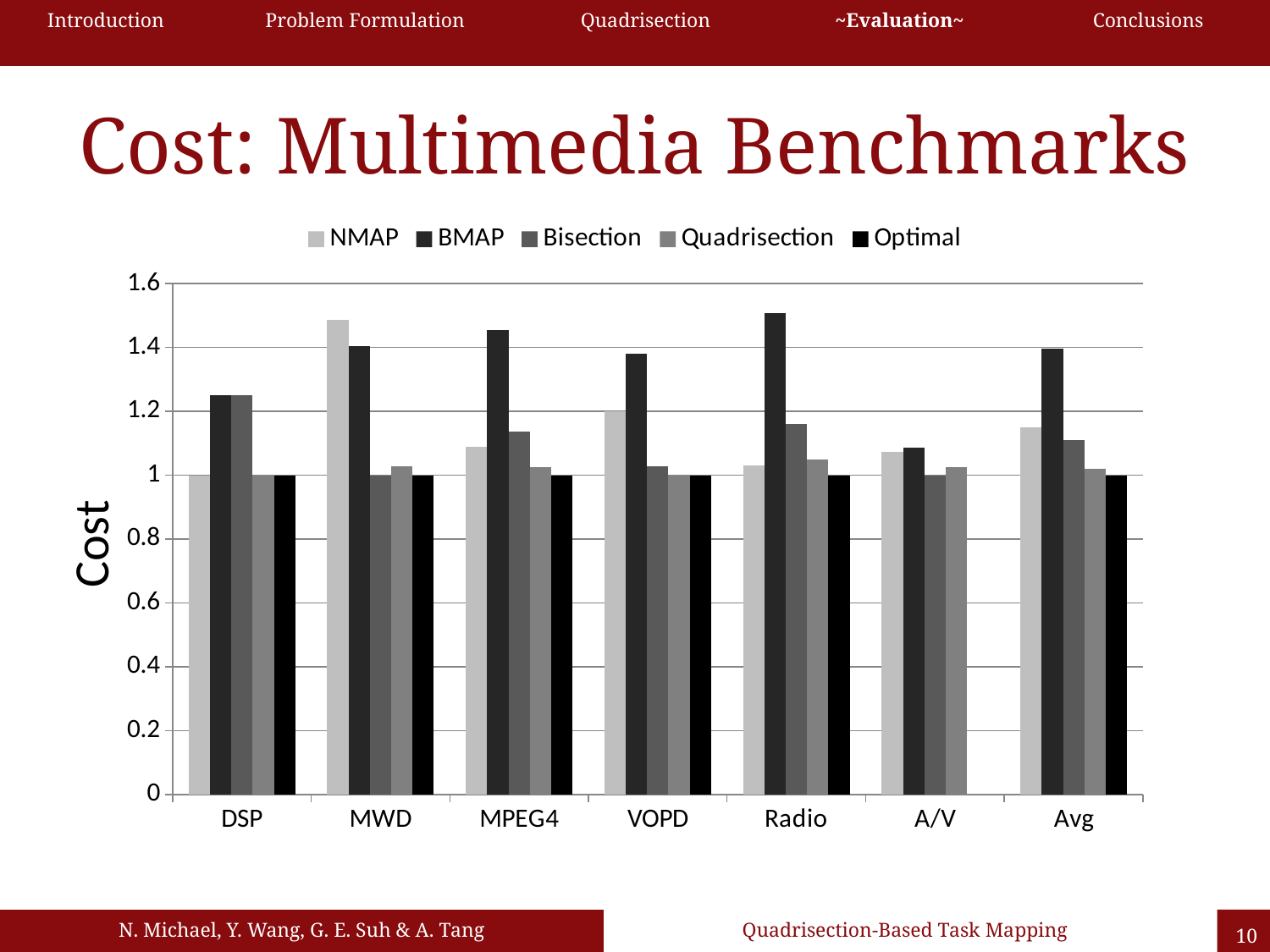
Which benchmark has the highest BMAP value? Radio Is the BMAP value for Radio greater or less than 1.4? greater Which benchmark has the highest NMAP value? MWD What is the label of the y axis? Cost Is the BMAP value for MPEG4 greater or less than 1.4? greater How many benchmark categories are shown on the x axis? 7 Is the NMAP value for MWD greater or less than 1.4? greater For DSP, which is larger, the NMAP value or the BMAP value? BMAP How many series does the legend list? 5 Which series is listed last in the legend? Optimal What kind of chart is shown on the slide? bar chart